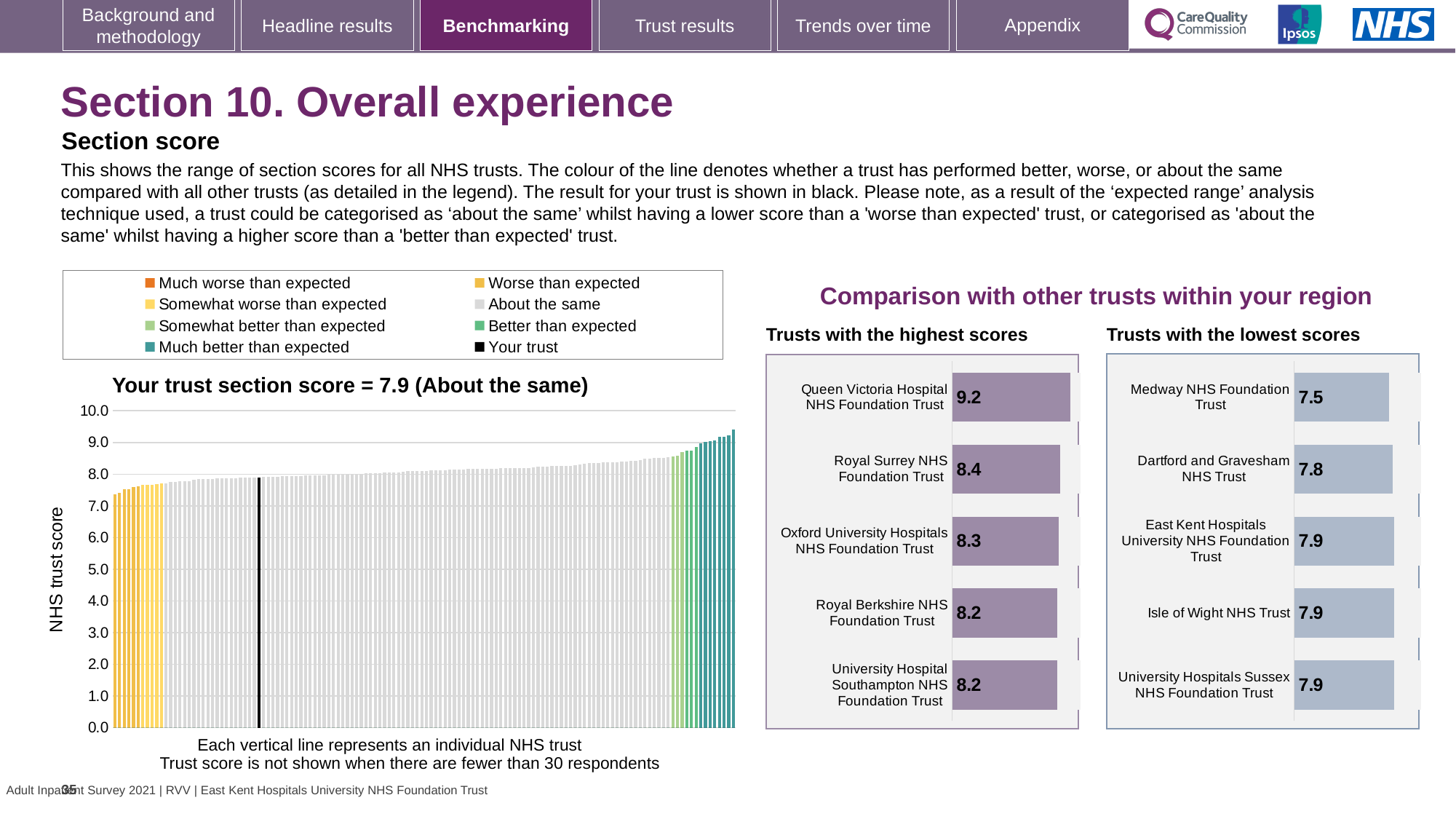
In the 'Your trust section score' chart, which category is your trust placed in? About the same In the 'Your trust section score' chart, is the value of the leftmost (lowest) bar greater or less than 8.0? less In the 'Your trust section score' chart, what is the section score for your trust? 7.9 In the 'Trusts with the lowest scores' chart, what is the score for Dartford and Gravesham NHS Trust? 7.8 What kind of chart is the 'Your trust section score' chart? bar chart In the 'Trusts with the lowest scores' chart, which trust has the lowest score? Medway NHS Foundation Trust In the 'Trusts with the highest scores' chart, what is the score for Queen Victoria Hospital NHS Foundation Trust? 9.2 How many entries does the legend above the 'Your trust section score' chart list? 8 In the 'Your trust section score' chart, is the value of the rightmost (highest) bar greater or less than 9.0? greater In the 'Your trust section score' chart, do the trust scores rise or fall from left to right along the x axis? rise How many trusts are shown in the 'Trusts with the highest scores' chart? 5 In the 'Trusts with the highest scores' chart, what is the difference between the scores of Queen Victoria Hospital NHS Foundation Trust and Royal Surrey NHS Foundation Trust? 0.8